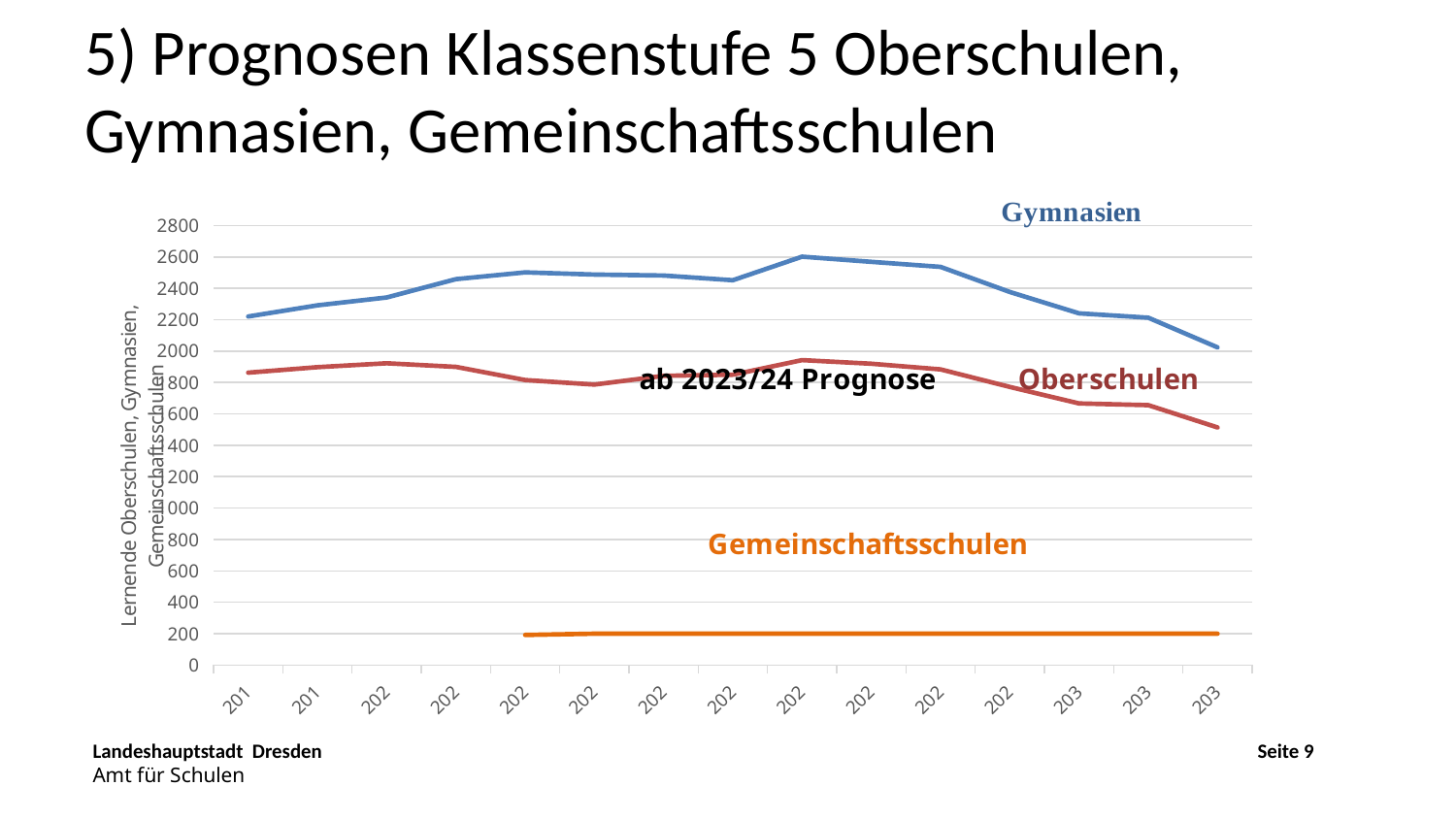
Are the values of the Gemeinschaftsschulen line greater or less than 400? less Is the peak value of the Oberschulen line greater or less than 2000? less What colour is the Gemeinschaftsschulen line? orange Which series has the highest values throughout the chart? Gymnasien What kind of chart is shown on the slide? line chart Is the peak value of the Gymnasien line greater or less than 2400? greater Which series is larger, Gymnasien or Oberschulen? Gymnasien How many series are plotted in the chart? 3 How many points are plotted on the Gymnasien line? 15 Which series has the lowest values throughout the chart? Gemeinschaftsschulen Does the Oberschulen line overall rise or fall from the first to the last point? fall